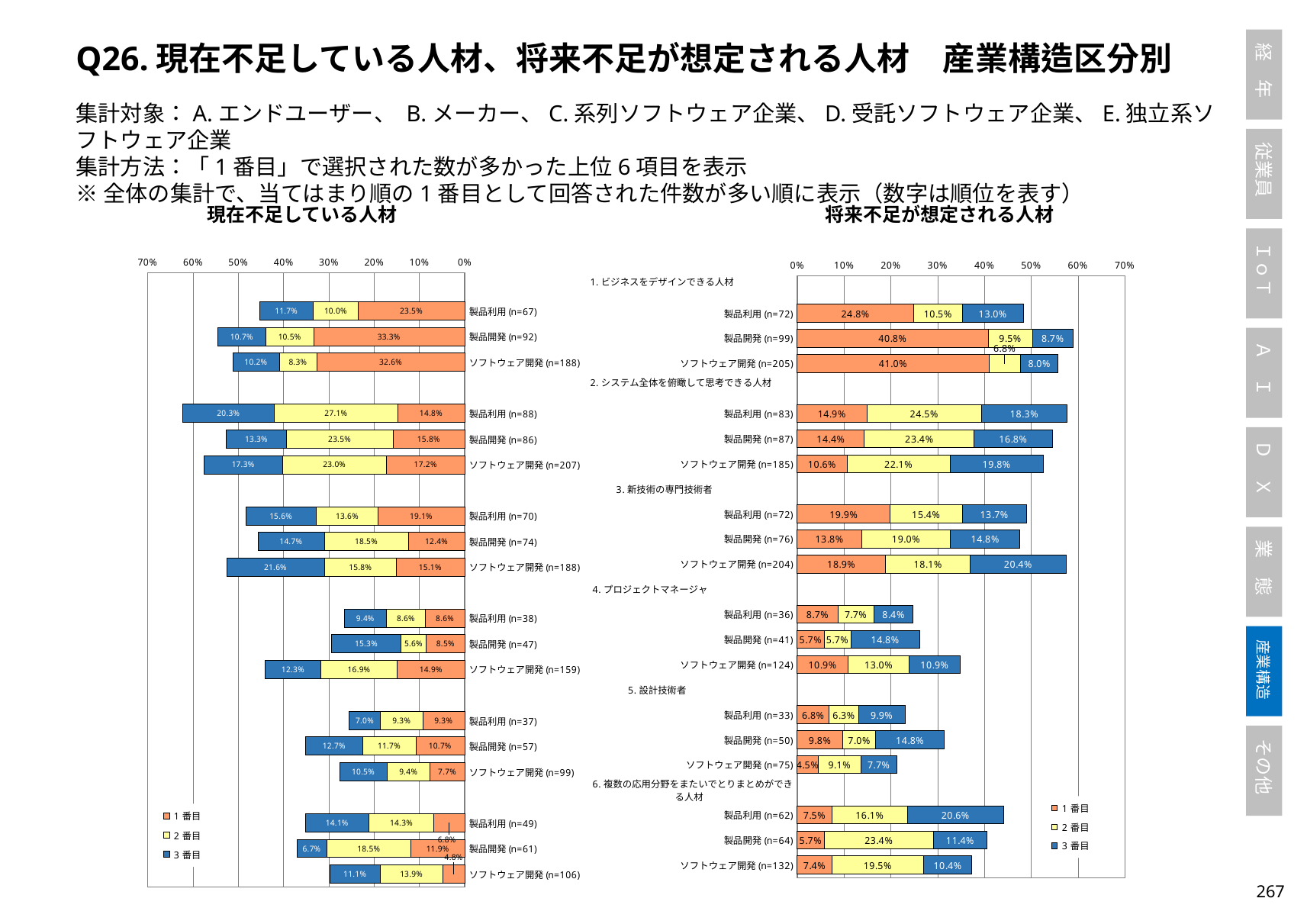
In the right chart (将来不足が想定される人材), which colour represents 1番目? Orange In the right chart (将来不足が想定される人材), what is the 2番目 value for 製品開発 (n=64) under 複数の応用分野をまたいでとりまとめができる人材? 23.4% In the left chart (現在不足している人材), what is the 3番目 value for ソフトウェア開発 (n=188) under 新技術の専門技術者? 21.6% How many series does the legend of the left chart (現在不足している人材) list? 3 In the left chart (現在不足している人材), what is the 1番目 value for 製品開発 (n=92) under ビジネスをデザインできる人材? 33.3% What kind of chart is the right chart (将来不足が想定される人材)? Stacked horizontal bar chart In the right chart (将来不足が想定される人材), which is larger for 製品利用 (n=83) under システム全体を俯瞰して思考できる人材: the 2番目 value or the 3番目 value? 2番目 (24.5%) In the left chart (現在不足している人材), which bar has the largest 2番目 segment? 製品利用 (n=88) In the right chart (将来不足が想定される人材), what is the difference between the 1番目 values for ソフトウェア開発 (n=205) and 製品利用 (n=72) under ビジネスをデザインできる人材? 16.2 percentage points In the left chart (現在不足している人材), what is the total of the stacked bar for 製品開発 (n=92) under ビジネスをデザインできる人材? 54.5% In the right chart (将来不足が想定される人材), what is the 1番目 value for ソフトウェア開発 (n=205) under ビジネスをデザインできる人材? 41.0% In the right chart (将来不足が想定される人材), what is the total of the stacked bar for 製品開発 (n=99) under ビジネスをデザインできる人材? 59.0%